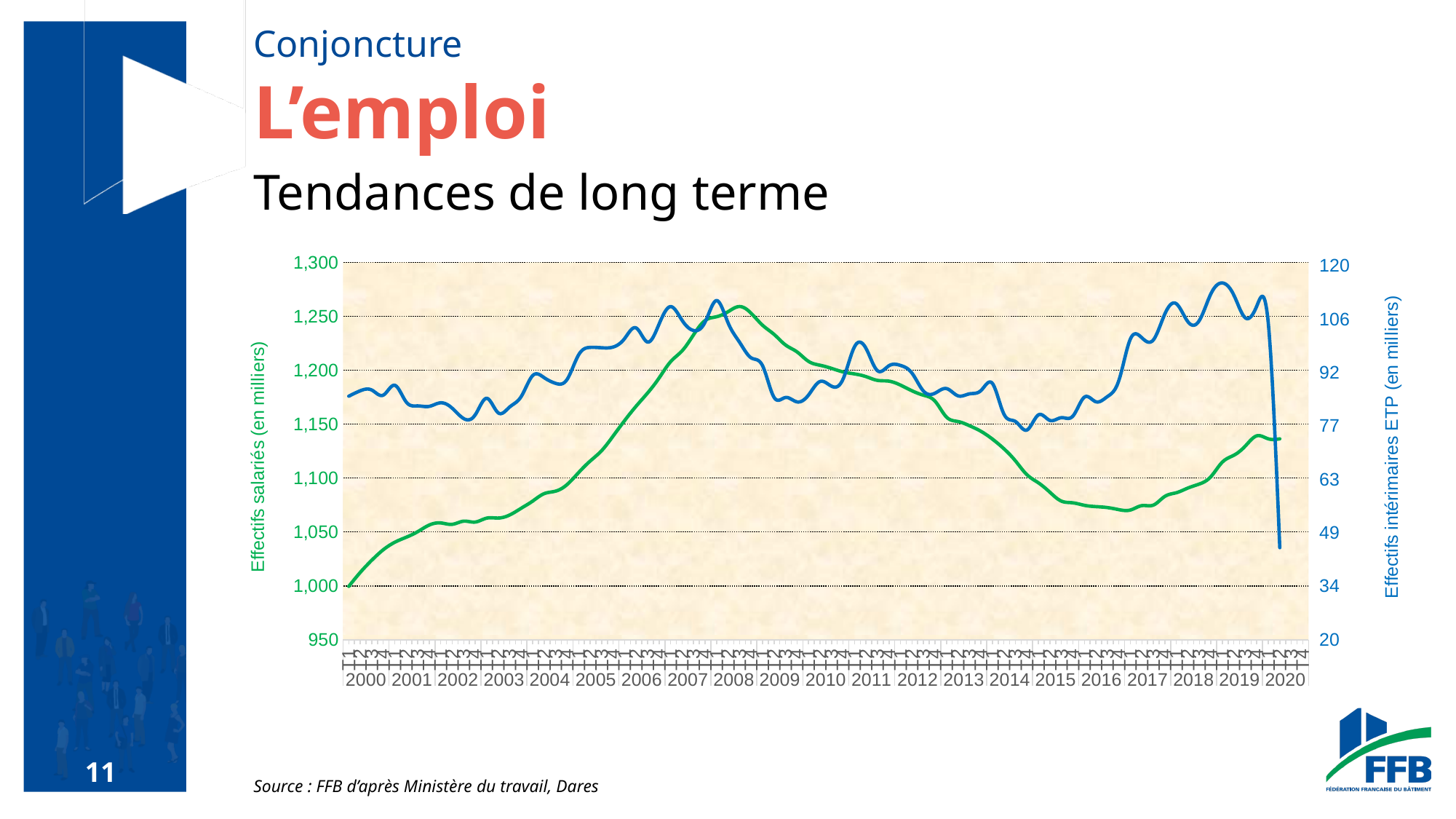
Is the value of the green 'Effectifs salariés' line in 2015 greater or less than 1,100? less What is the title of the left vertical axis of the chart? Effectifs salariés (en milliers) Is the peak value of the blue 'Effectifs intérimaires ETP' line in 2019 greater or less than 106? greater Which colour is the line for 'Effectifs intérimaires ETP (en milliers)'? Blue In which year does the blue 'Effectifs intérimaires ETP' line reach its highest point? 2019 How many years are labelled along the x axis of the chart? 21 Does the green 'Effectifs salariés' line rise or fall between 2008 and 2015? Fall Does the green 'Effectifs salariés' line rise or fall between 2000 and 2008? Rise In which year does the blue 'Effectifs intérimaires ETP' line reach its lowest point? 2020 In which year does the green 'Effectifs salariés' line reach its lowest point? 2000 What kind of chart is shown on the slide? Line chart In which year does the green 'Effectifs salariés' line reach its highest point? 2008